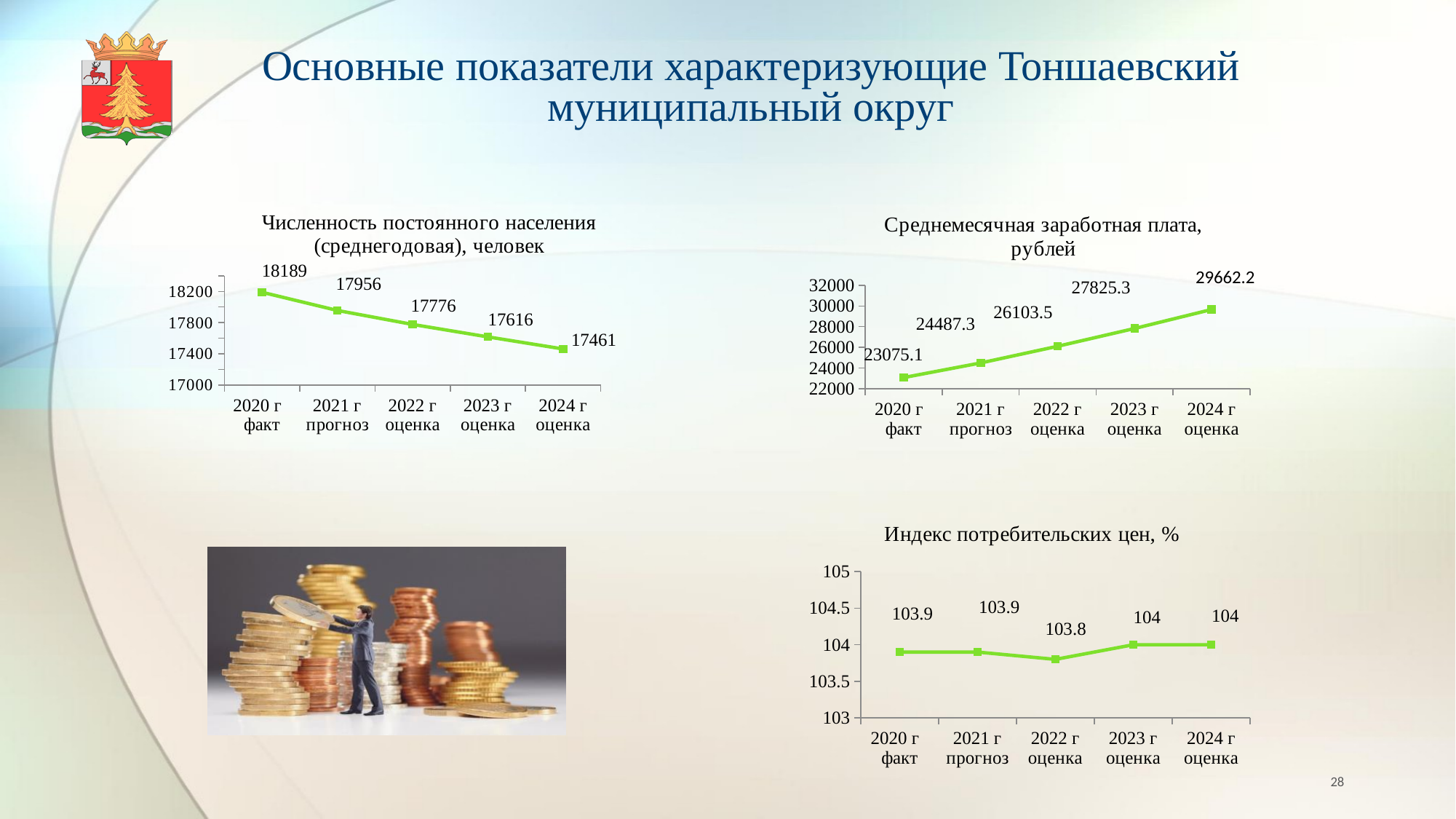
In the chart 'Численность постоянного населения (среднегодовая), человек', do the values rise or fall from 2020 to 2024? fall In the chart 'Индекс потребительских цен, %', what is the value for 2022 г оценка? 103.8 In the chart 'Индекс потребительских цен, %', how many data points are plotted? 5 In the chart 'Среднемесячная заработная плата, рублей', what is the value for 2022 г оценка? 26103.5 In the chart 'Индекс потребительских цен, %', which year has the lowest value? 2022 г оценка In the chart 'Численность постоянного населения (среднегодовая), человек', what is the difference between the 2020 г факт and 2021 г прогноз values? 233 In the chart 'Численность постоянного населения (среднегодовая), человек', what is the value for 2024 г оценка? 17461 In the chart 'Численность постоянного населения (среднегодовая), человек', what is the value for 2020 г факт? 18189 In the chart 'Среднемесячная заработная плата, рублей', which year has the lowest value? 2020 г факт What kind of chart is 'Среднемесячная заработная плата, рублей'? line chart In the chart 'Среднемесячная заработная плата, рублей', which year has the highest value? 2024 г оценка In the chart 'Среднемесячная заработная плата, рублей', do the values rise or fall from 2020 to 2024? rise